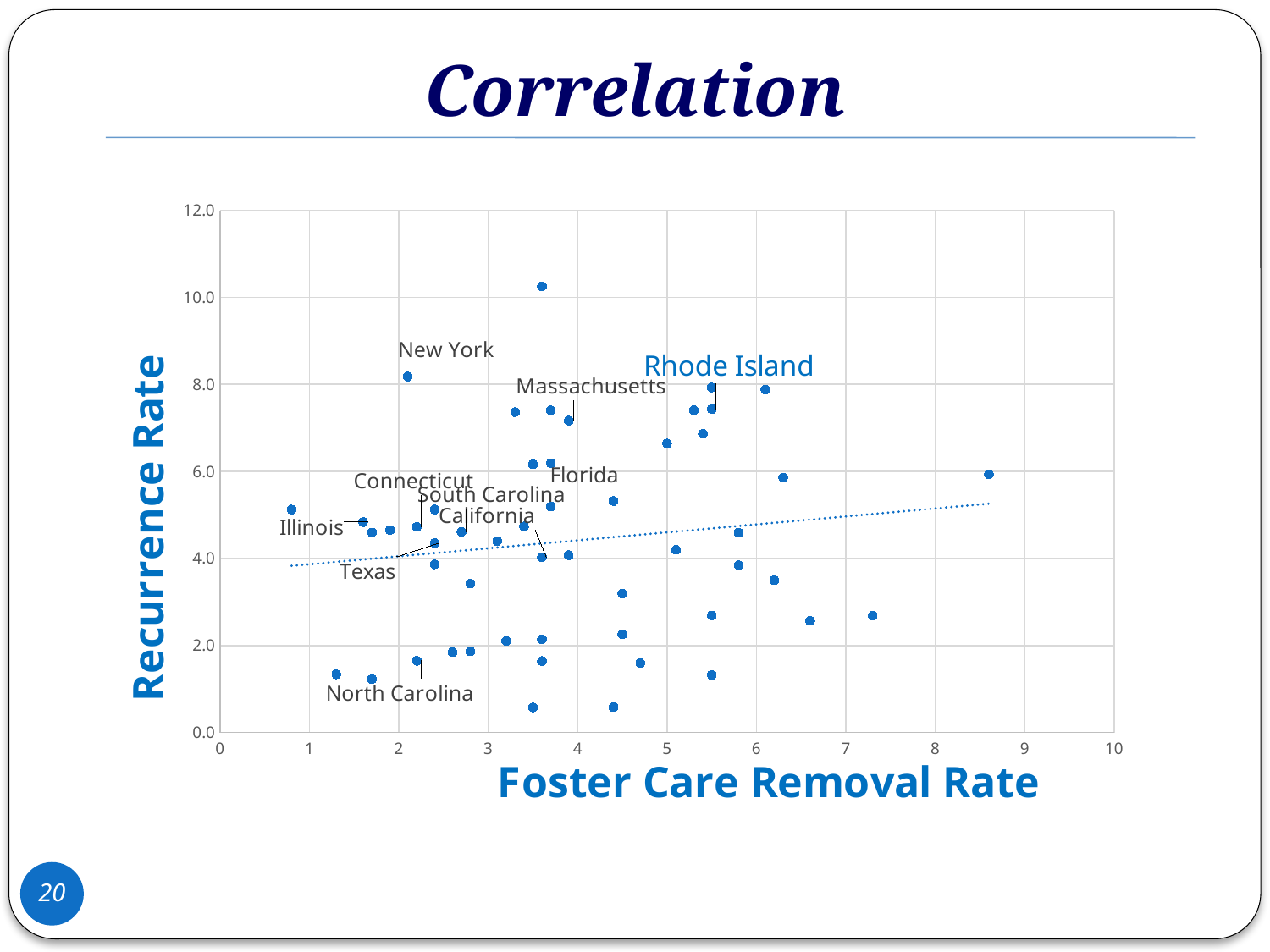
Is the recurrence rate for Texas greater or less than 6.0? less Does the dotted trend line rise or fall as the foster care removal rate increases? rise Is the foster care removal rate for Rhode Island greater or less than 5? greater What kind of chart is shown on the slide? Scatter chart What is the title of the y axis of the chart? Recurrence Rate Which has the higher foster care removal rate, Rhode Island or Illinois? Rhode Island Is the recurrence rate for Massachusetts greater or less than 6.0? greater Which has the higher recurrence rate, New York or North Carolina? New York What is the title of the x axis of the chart? Foster Care Removal Rate